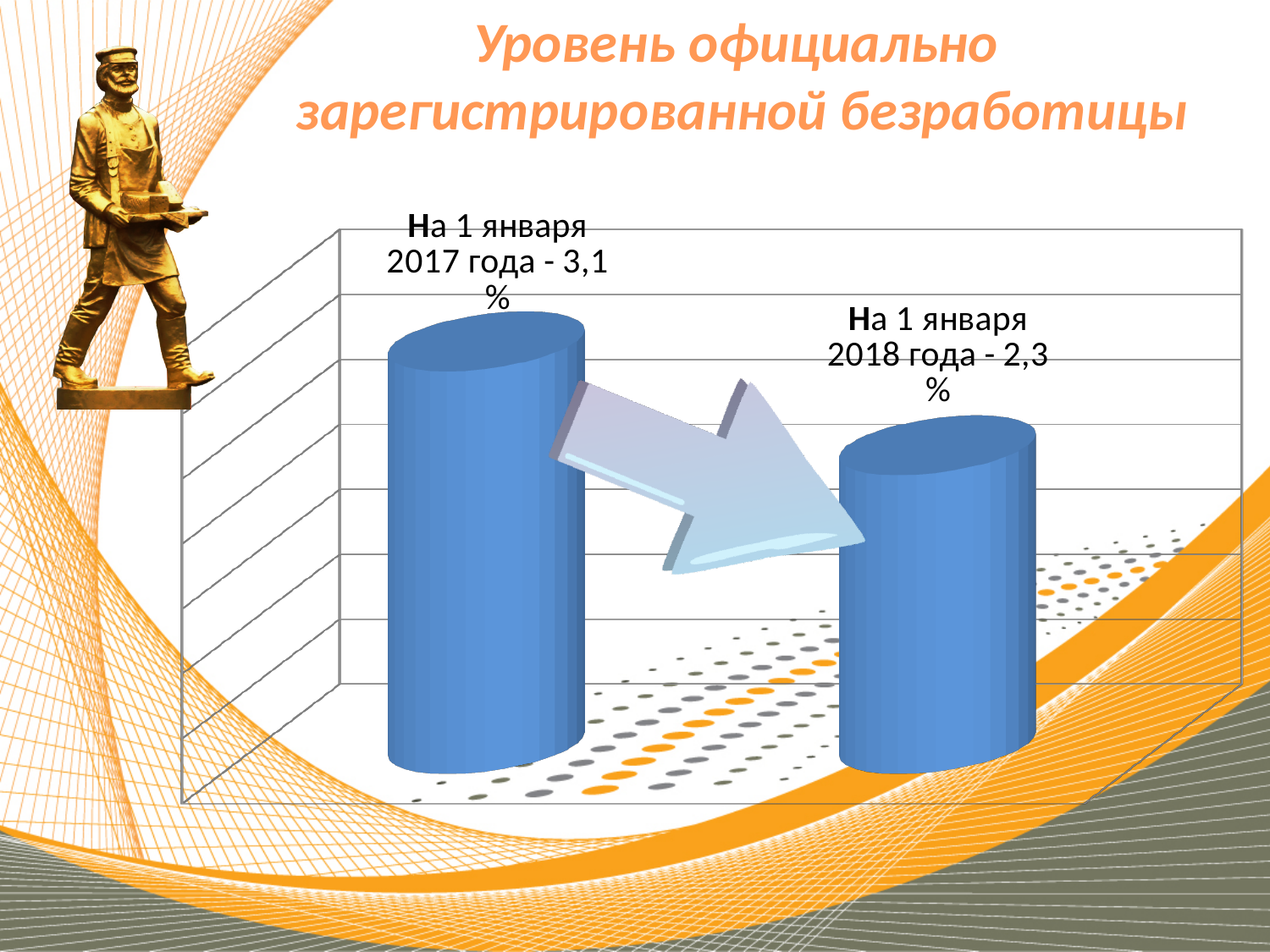
What is the title of the slide? Уровень официально зарегистрированной безработицы What is the value shown for 1 January 2018 (На 1 января 2018 года)? 2,3 % How many bars are plotted on the chart? 2 What kind of chart is shown on the slide? bar chart Is the value for 1 January 2017 larger or smaller than the value for 1 January 2018? larger Which of the two dates has the lower unemployment level? На 1 января 2018 года What colour are the bars on the chart? blue What is the value shown for 1 January 2017 (На 1 января 2017 года)? 3,1 % By how much did the value fall from 1 January 2017 to 1 January 2018? 0,8 % Do the values rise or fall from the left bar to the right bar? fall Which of the two dates has the higher unemployment level? На 1 января 2017 года